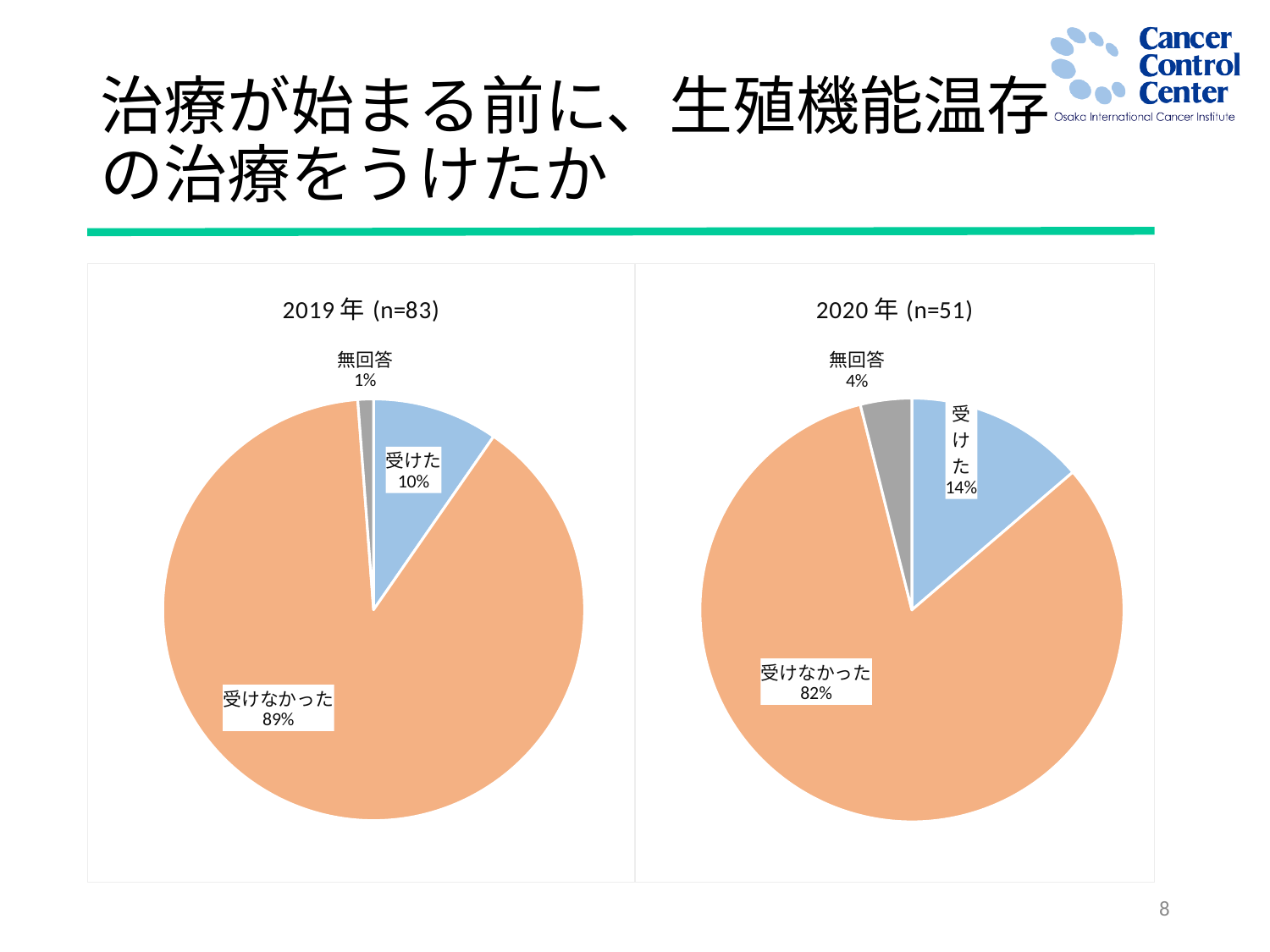
In the 2020年 (n=51) pie chart, what share is labelled 受けた? 14% In the 2020年 (n=51) pie chart, what share is labelled 無回答? 4% What is the title of the chart on the right side of the slide? 2020年 (n=51) In the 2019年 (n=83) pie chart, what share is labelled 受けた? 10% In the 2019年 (n=83) pie chart, what share is labelled 受けなかった? 89% In the 2020年 (n=51) pie chart, which slice is the smallest? 無回答 In the 2020年 (n=51) pie chart, what is the difference between the 受けなかった share and the 無回答 share? 78% Which is larger: the 受けた share in the 2019年 (n=83) chart or the 受けた share in the 2020年 (n=51) chart? 2020年 (n=51) In the 2019年 (n=83) pie chart, what is the difference between the 受けなかった share and the 受けた share? 79% What kind of chart is the 2019年 (n=83) chart? Pie chart In the 2019年 (n=83) pie chart, which slice is the largest? 受けなかった How many slices does the 2020年 (n=51) pie chart have? 3